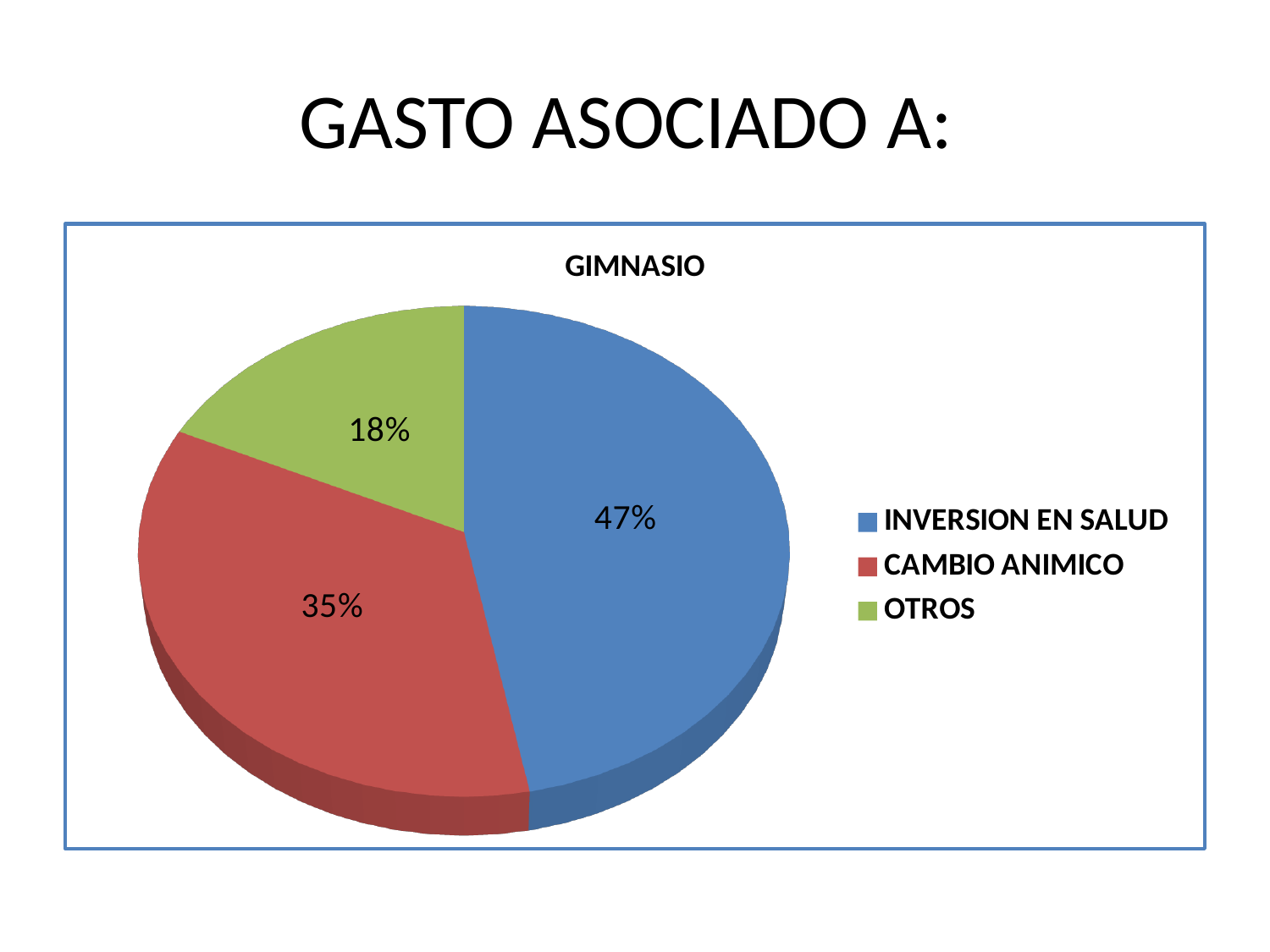
What percentage of the pie is CAMBIO ANIMICO? 35% What type of chart is shown on the slide? Pie chart What percentage of the pie is OTROS? 18% What is the difference in percentage points between CAMBIO ANIMICO and OTROS? 17 Which colour represents OTROS in the legend? Green What is the difference in percentage points between INVERSION EN SALUD and CAMBIO ANIMICO? 12 What percentage of the pie is INVERSION EN SALUD? 47% What is the chart's title? GIMNASIO How many slices does the pie chart have? 3 Which category has the largest share of the pie? INVERSION EN SALUD Which is larger, the share for CAMBIO ANIMICO or the share for OTROS? CAMBIO ANIMICO Which category has the smallest share of the pie? OTROS